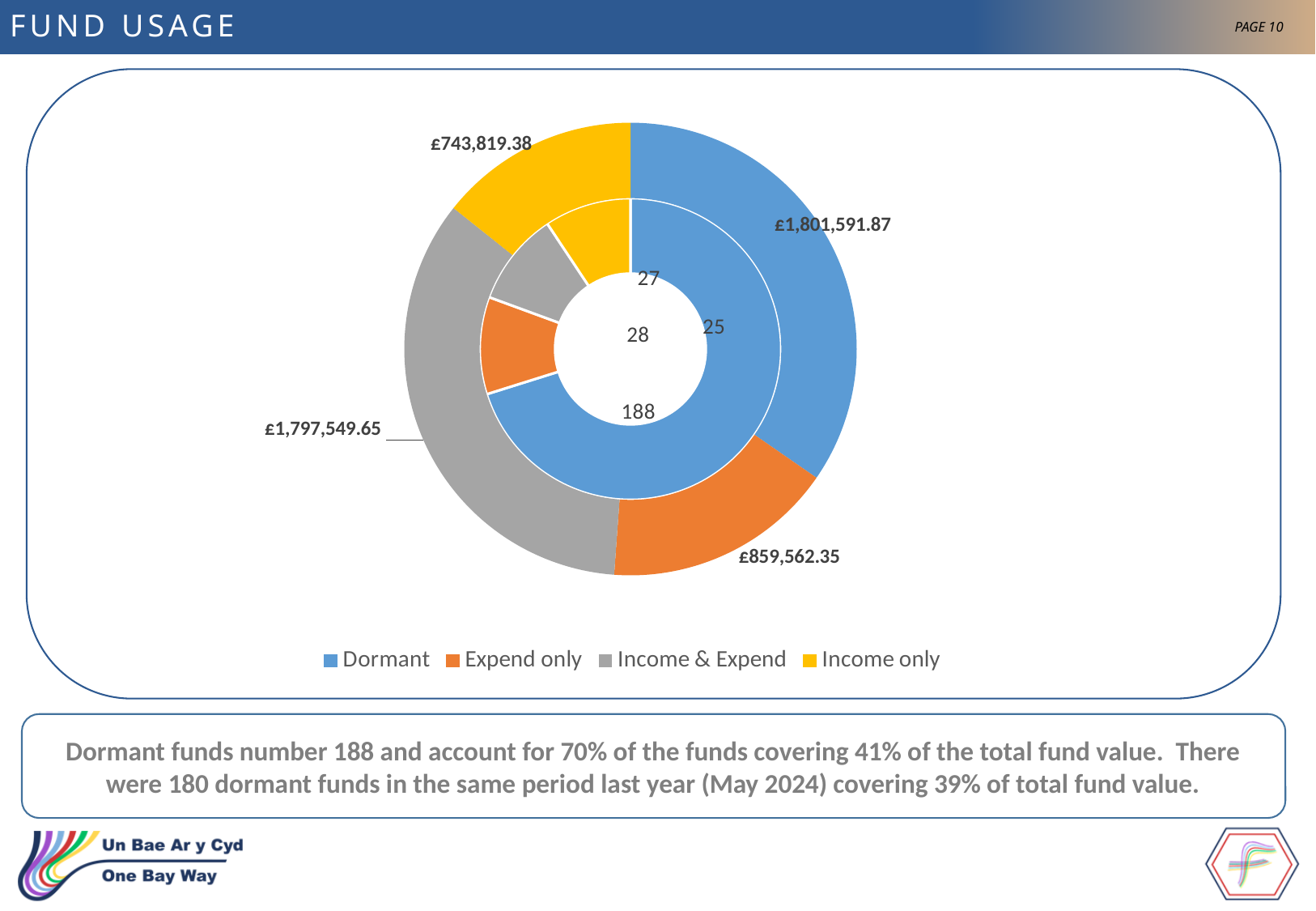
Which has the larger fund value, Expend only or Income only? Expend only What is the fund value shown for Income & Expend on the outer ring? £1,797,549.65 What kind of chart is shown on the slide? Doughnut chart What is the difference between the fund values for Dormant and Income & Expend? £4,042.22 How many categories does the legend of the chart list? 4 What is the fund value shown for Expend only on the outer ring? £859,562.35 How many Dormant funds are shown on the inner ring? 188 What is the difference between the fund values for Expend only and Income only? £115,742.97 Which category has the lowest fund value on the outer ring? Income only What is the fund value shown for Dormant on the outer ring? £1,801,591.87 What is the fund value shown for Income only on the outer ring? £743,819.38 Which colour represents Income & Expend in the chart? Grey